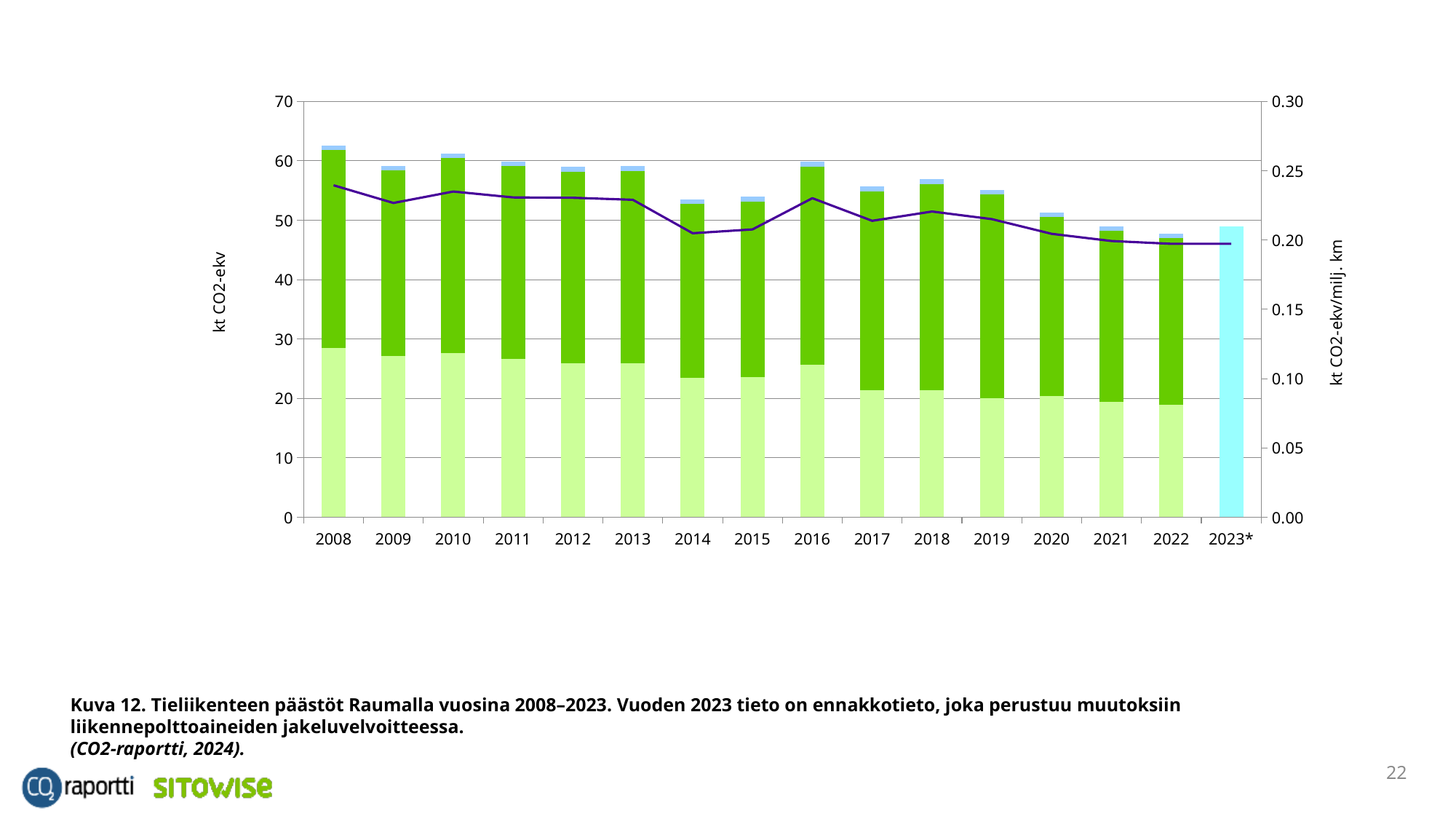
Do the total bar heights generally rise or fall from 2008 to 2022? fall Is the total bar height for 2022 greater or less than 50 kt CO2-ekv? less Which year has the larger total bar, 2016 or 2017? 2016 Is the total bar height for 2008 greater or less than 60 kt CO2-ekv? greater What kind of chart is shown on the slide? Stacked bar chart with a line What is the title of the right vertical axis? kt CO2-ekv/milj. km How many years are shown on the x axis of the chart? 16 Is the total bar height for 2016 greater or less than 50 kt CO2-ekv? greater What is the title of the left vertical axis? kt CO2-ekv Which year has the larger total bar, 2008 or 2022? 2008